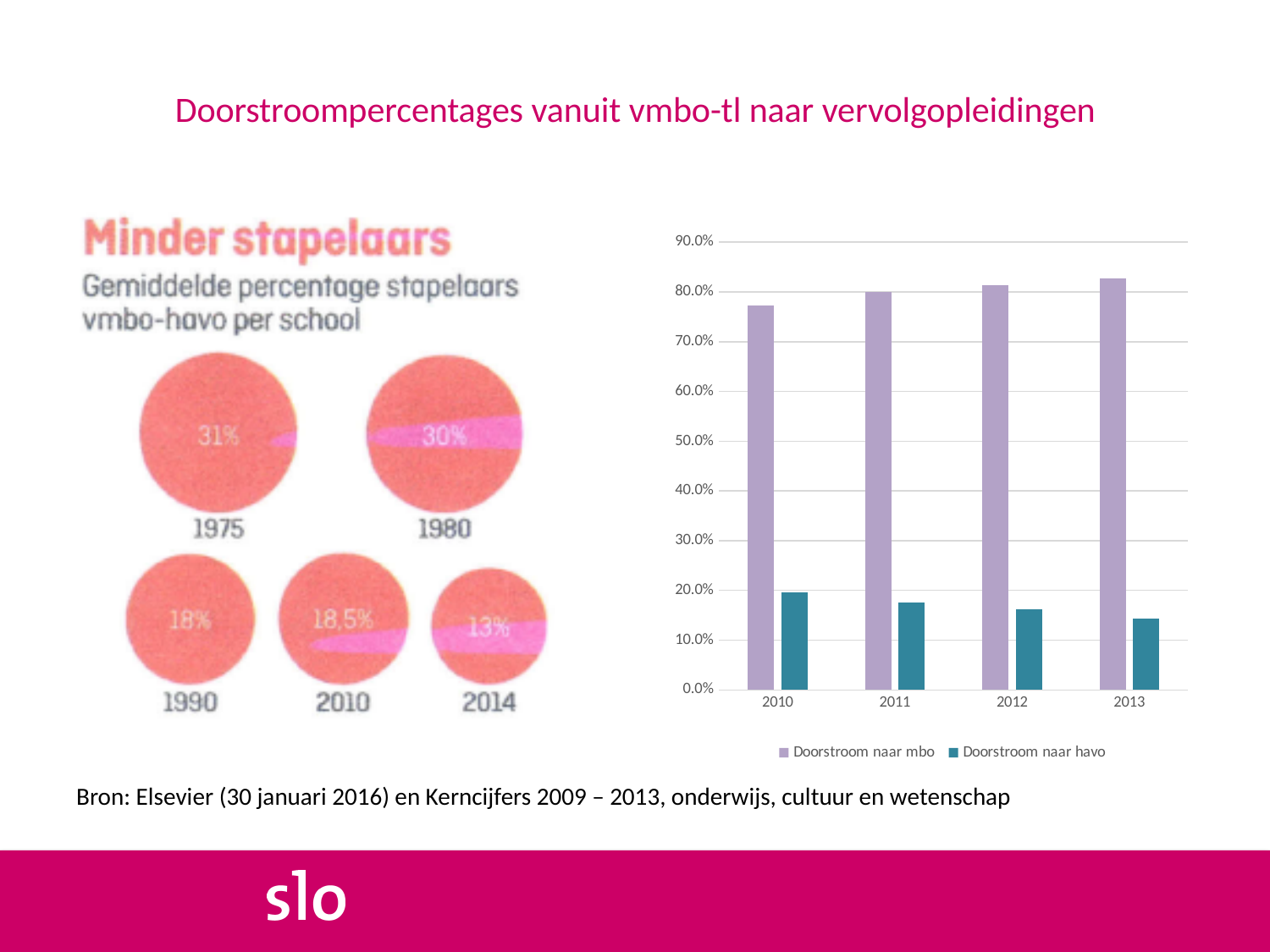
In the bar chart on the right, does Doorstroom naar havo rise or fall from 2010 to 2013? Fall In the bar chart on the right, how many series does the legend list? 2 In the bar chart on the right, what are the two series named in the legend? Doorstroom naar mbo and Doorstroom naar havo In the 'Minder stapelaars' infographic on the left, what is the percentage shown for 2014? 13% In the bar chart on the right, how many years are shown on the x axis? 4 In the bar chart on the right, is the value for Doorstroom naar mbo in 2010 greater or less than 80.0%? less In the bar chart on the right, is the value for Doorstroom naar mbo in 2013 greater or less than 80.0%? greater In the bar chart on the right, is the value for Doorstroom naar havo in 2010 greater or less than 10.0%? greater In the 'Minder stapelaars' infographic on the left, which year has the lowest percentage? 2014 What kind of chart is shown on the right side of the slide? Bar chart In the 'Minder stapelaars' infographic on the left, what is the percentage shown for 1975? 31% In the bar chart on the right, does Doorstroom naar mbo rise or fall from 2010 to 2013? Rise